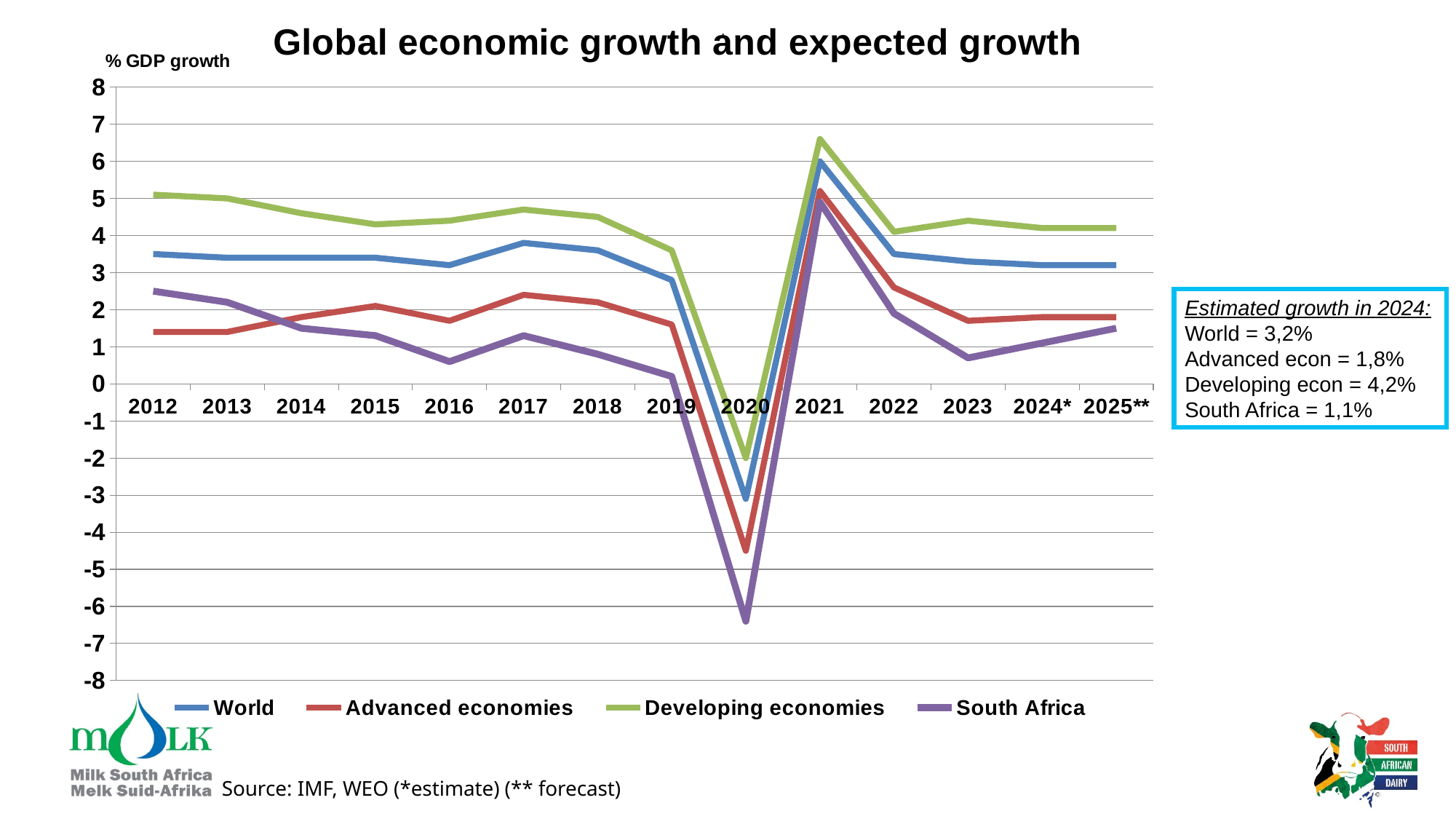
How many series does the legend list? 4 What is the difference between the 2024 estimated growth for Developing economies and Advanced economies shown in the text box? 2,4% According to the text box, what is the estimated growth for the World in 2024? 3,2% In which year does the South Africa line reach its lowest value? 2020 In which year does the Developing economies line reach its highest value? 2021 Which series has the higher value in 2012, World or South Africa? World Is the value for South Africa in 2020 greater or less than -6? less According to the text box, what is the estimated growth for South Africa in 2024? 1,1% How many years are shown along the x axis? 14 According to the text box, what is the estimated growth for Developing economies in 2024? 4,2% Does the Developing economies line rise or fall from 2012 to 2016? fall What kind of chart is shown on the slide? line chart